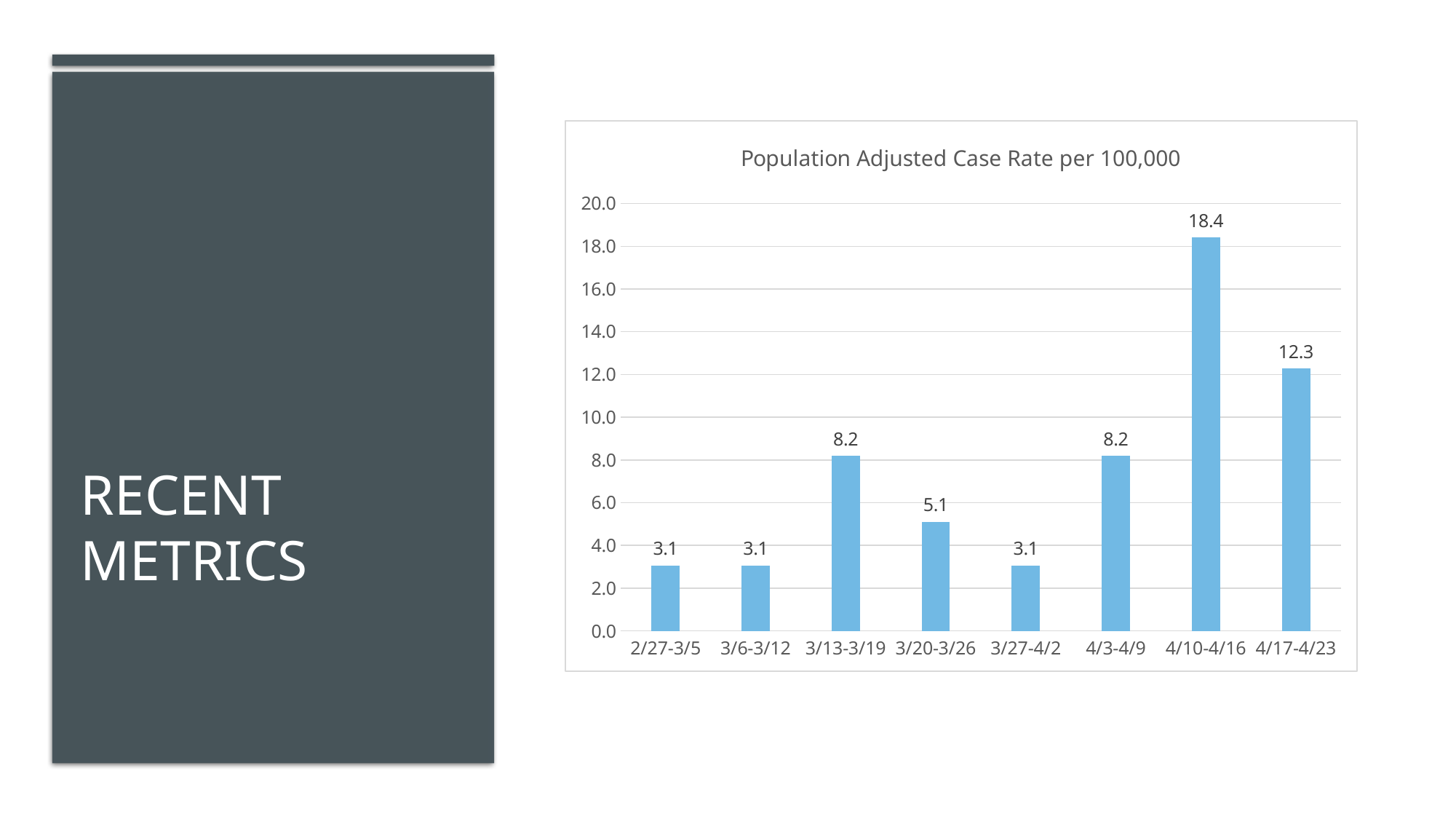
What kind of chart is shown on the slide? Bar chart What is the value shown for the week 3/20-3/26? 5.1 What is the lowest value shown on the chart? 3.1 Is the value for 4/10-4/16 greater or less than 16.0? greater What is the value shown for the week 4/17-4/23? 12.3 Which week has the highest Population Adjusted Case Rate per 100,000? 4/10-4/16 How many weekly periods are shown on the x axis? 8 What is the difference between the values for 4/10-4/16 and 4/17-4/23? 6.1 Which is larger, the value for 4/3-4/9 or the value for 3/27-4/2? 4/3-4/9 What is the Population Adjusted Case Rate per 100,000 for the week 4/10-4/16? 18.4 What is the difference between the values for 3/13-3/19 and 3/20-3/26? 3.1 What is the title of the chart? Population Adjusted Case Rate per 100,000